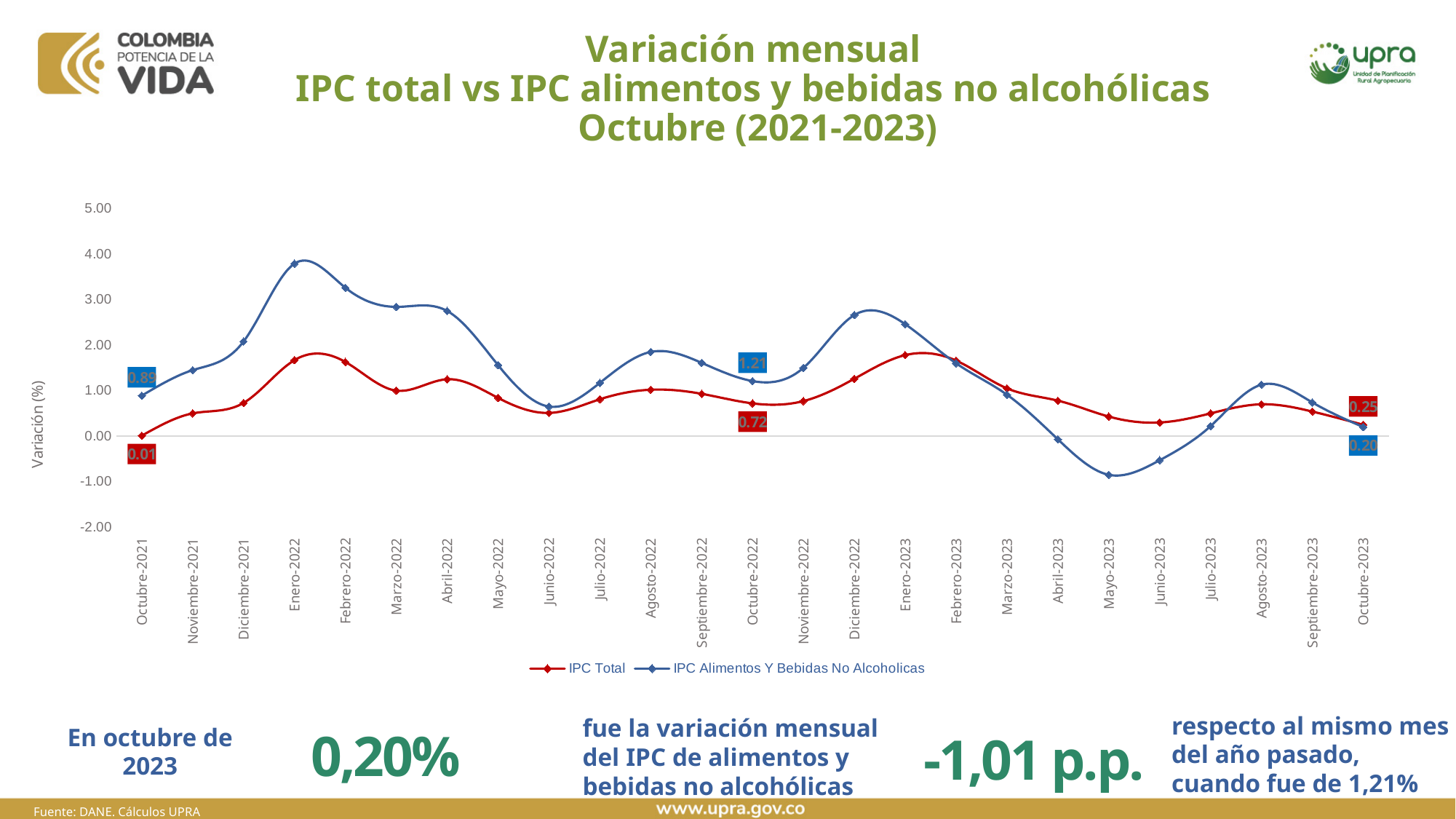
In Octubre-2023, which series has the larger value, IPC Total or IPC Alimentos Y Bebidas No Alcoholicas? IPC Total How many series does the legend list? 2 Is the value of IPC Alimentos Y Bebidas No Alcoholicas for Enero-2022 greater or less than 3.00? greater What is the value of IPC Alimentos Y Bebidas No Alcoholicas for Octubre-2023? 0.20 In which month does the IPC Alimentos Y Bebidas No Alcoholicas series reach its highest value? Enero-2022 How many months are shown on the x axis of the chart? 25 In which month does the IPC Alimentos Y Bebidas No Alcoholicas series reach its lowest value? Mayo-2023 What is the value of IPC Alimentos Y Bebidas No Alcoholicas for Octubre-2021? 0.89 What type of chart is shown on the slide? line chart What is the difference between IPC Alimentos Y Bebidas No Alcoholicas and IPC Total in Octubre-2022? 0.49 What is the value of IPC Total for Octubre-2021? 0.01 What is the value of IPC Total for Octubre-2022? 0.72